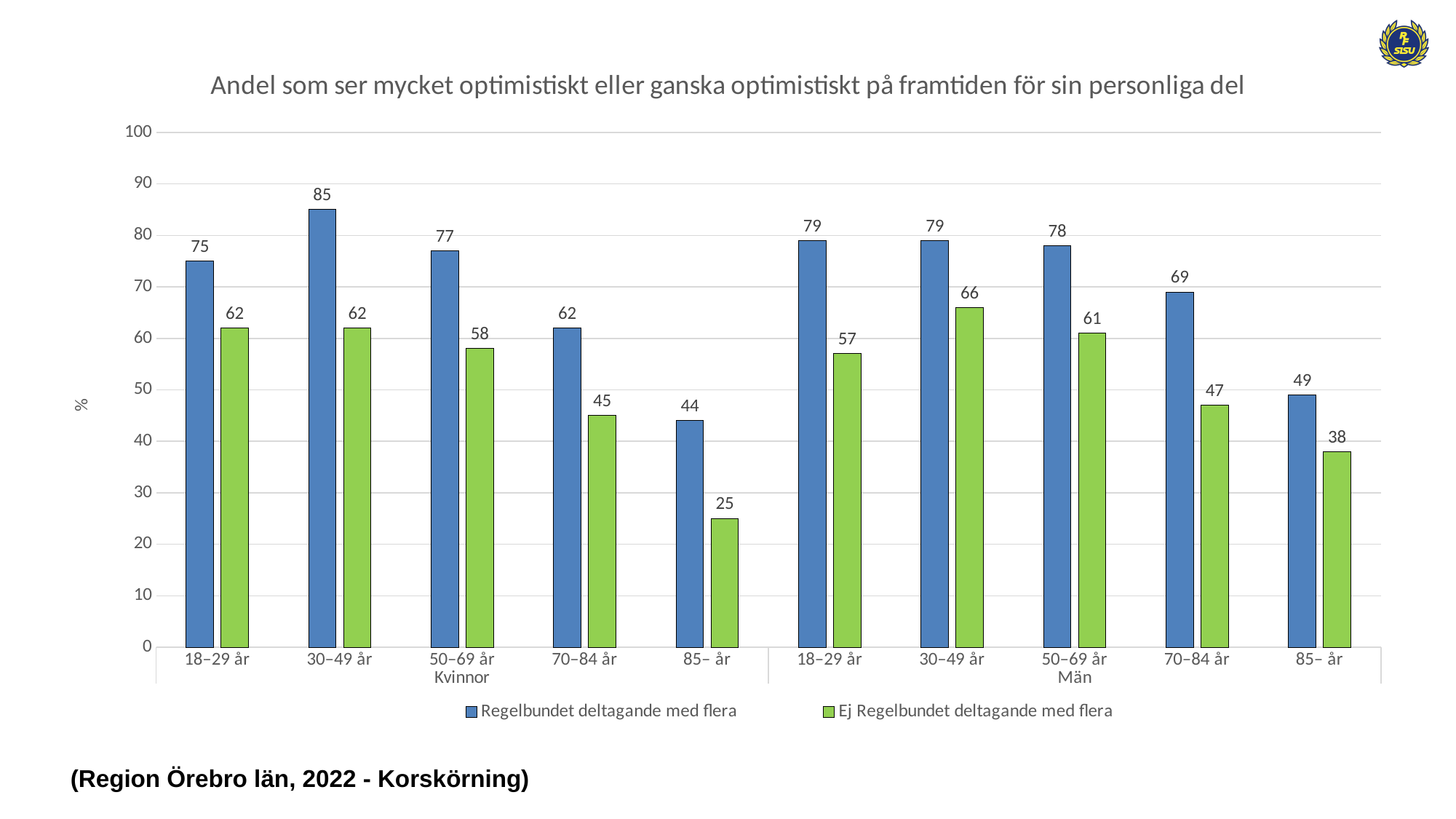
Which group has the highest value for 'Regelbundet deltagande med flera'? Kvinnor 30–49 år Do the values for 'Regelbundet deltagande med flera' rise or fall from 50–69 år to 85– år among Män? Fall How many series does the legend list? 2 What kind of chart is shown on the slide? Bar chart What is the value for 'Regelbundet deltagande med flera' for Kvinnor 30–49 år? 85 What is the value for 'Ej Regelbundet deltagande med flera' for Kvinnor 70–84 år? 45 Which group has the lowest value for 'Ej Regelbundet deltagande med flera'? Kvinnor 85– år Which is larger: 'Ej Regelbundet deltagande med flera' for Män 30–49 år or for Kvinnor 30–49 år? Män 30–49 år What is the difference between 'Regelbundet deltagande med flera' and 'Ej Regelbundet deltagande med flera' for Män 18–29 år? 22 What is the value for 'Ej Regelbundet deltagande med flera' for Män 85– år? 38 How many age groups are shown for Män? 5 What is the difference between the two series for Kvinnor 85– år? 19